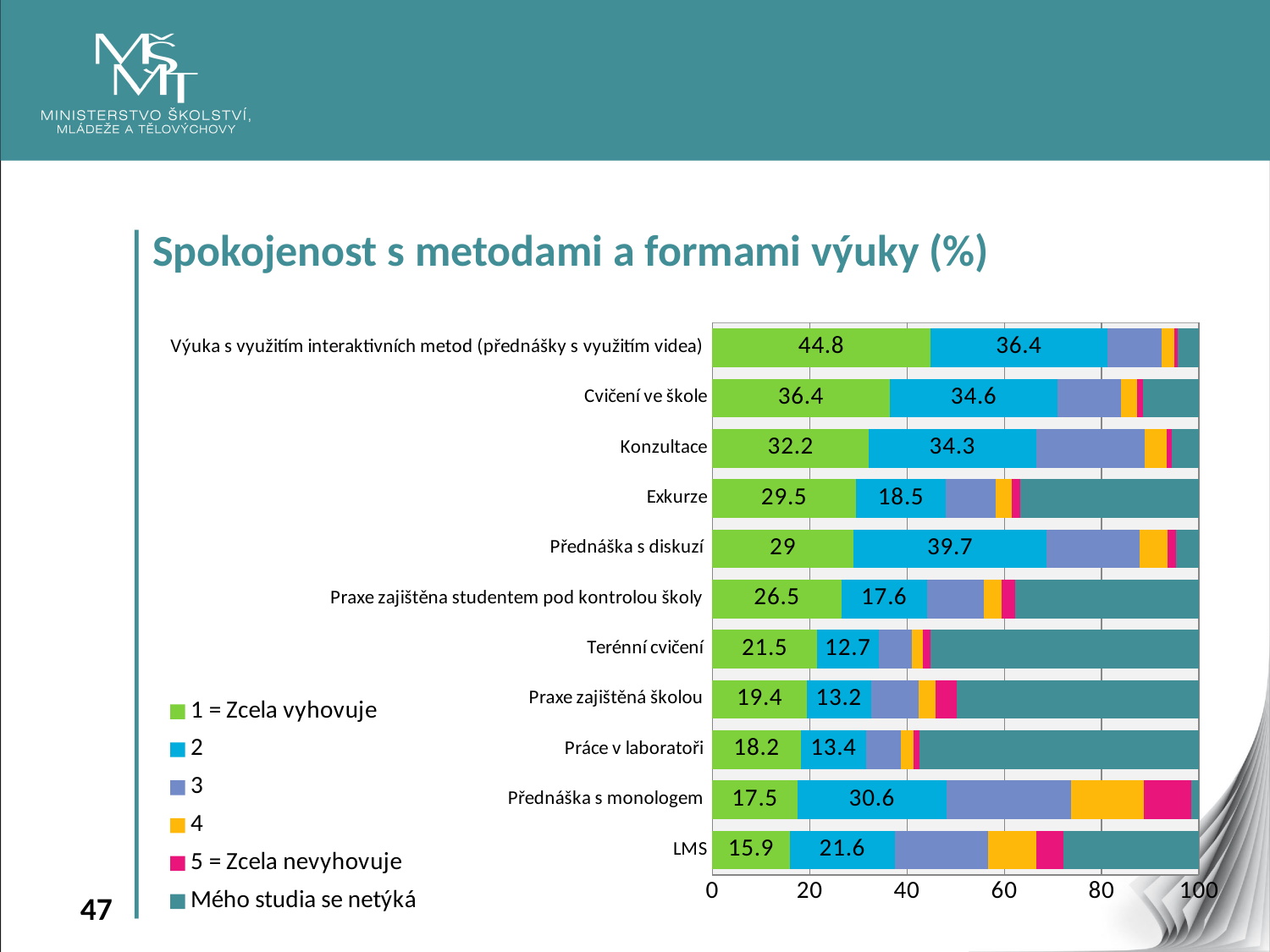
What is the title of the chart? Spokojenost s metodami a formami výuky (%) How many series does the legend list? 6 What is the value of "1 = Zcela vyhovuje" for "Výuka s využitím interaktivních metod (přednášky s využitím videa)"? 44.8 What kind of chart is shown on the slide? Stacked bar chart What is the value of series "2" for "Přednáška s diskuzí"? 39.7 Which category has the lowest value for series "2"? Terénní cvičení For "Konzultace", which is larger: the "1 = Zcela vyhovuje" value or the series "2" value? 2 (34.3) Which category has the highest value for "1 = Zcela vyhovuje"? Výuka s využitím interaktivních metod (přednášky s využitím videa) What is the value of series "2" for "Přednáška s monologem"? 30.6 What is the difference between the "1 = Zcela vyhovuje" value and the series "2" value for "Výuka s využitím interaktivních metod (přednášky s využitím videa)"? 8.4 What is the value of "1 = Zcela vyhovuje" for "LMS"? 15.9 How many categories are shown on the chart? 11